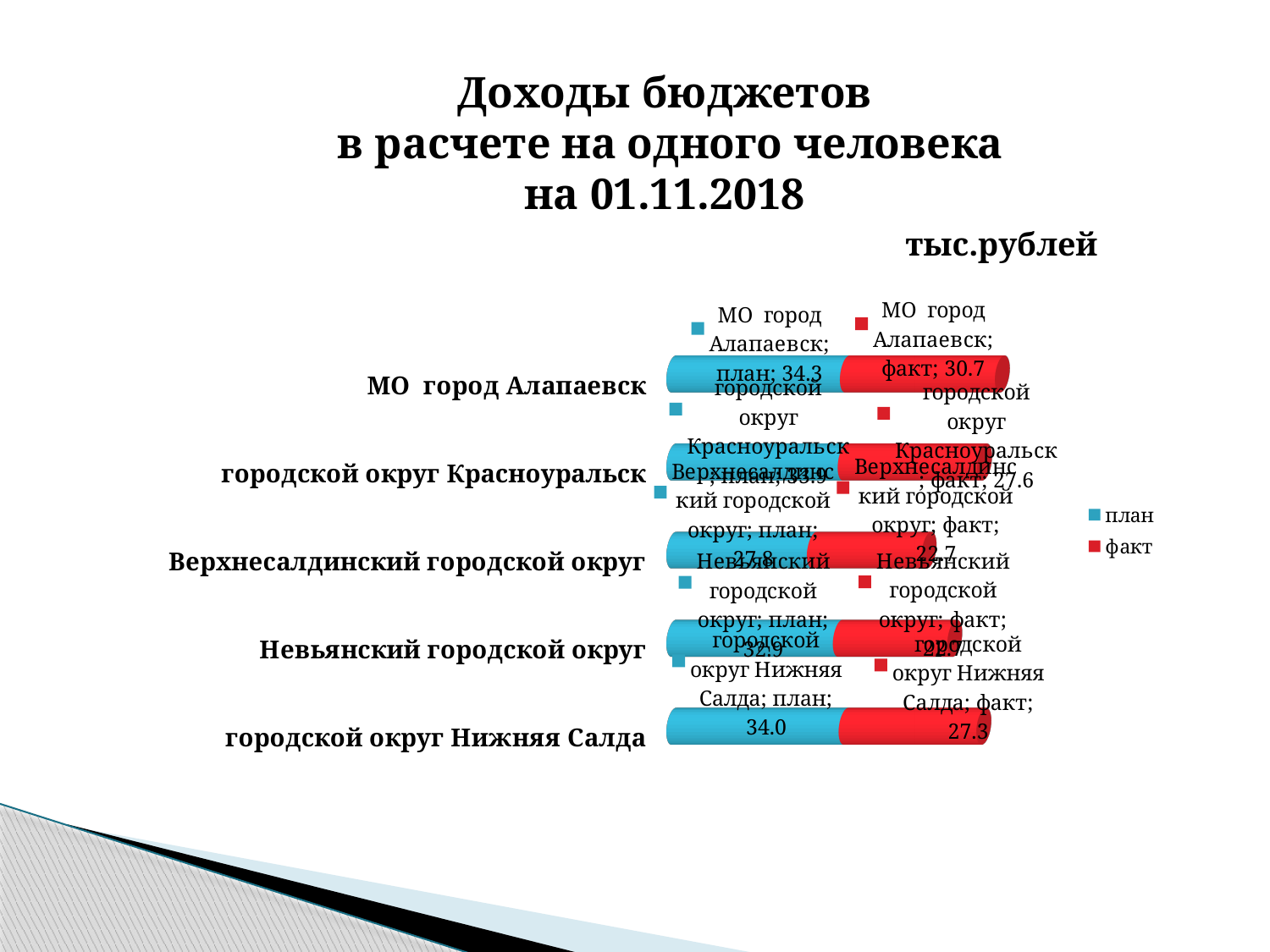
What is the факт value for МО город Алапаевск? 30.7 Which municipality has the highest факт value? МО город Алапаевск What kind of chart is shown on the slide? bar chart How many series does the legend list? 2 What is the план value for городской округ Нижняя Салда? 34.0 Which municipality has the lowest план value? Верхнесалдинский городской округ What is the difference between план and факт for городской округ Нижняя Салда? 6.7 What is the план value for МО город Алапаевск? 34.3 What is the факт value for Верхнесалдинский городской округ? 22.7 How many municipalities (categories) are shown in the chart? 5 What is the difference between план and факт for МО город Алапаевск? 3.6 Which colour represents the факт series in the legend? red